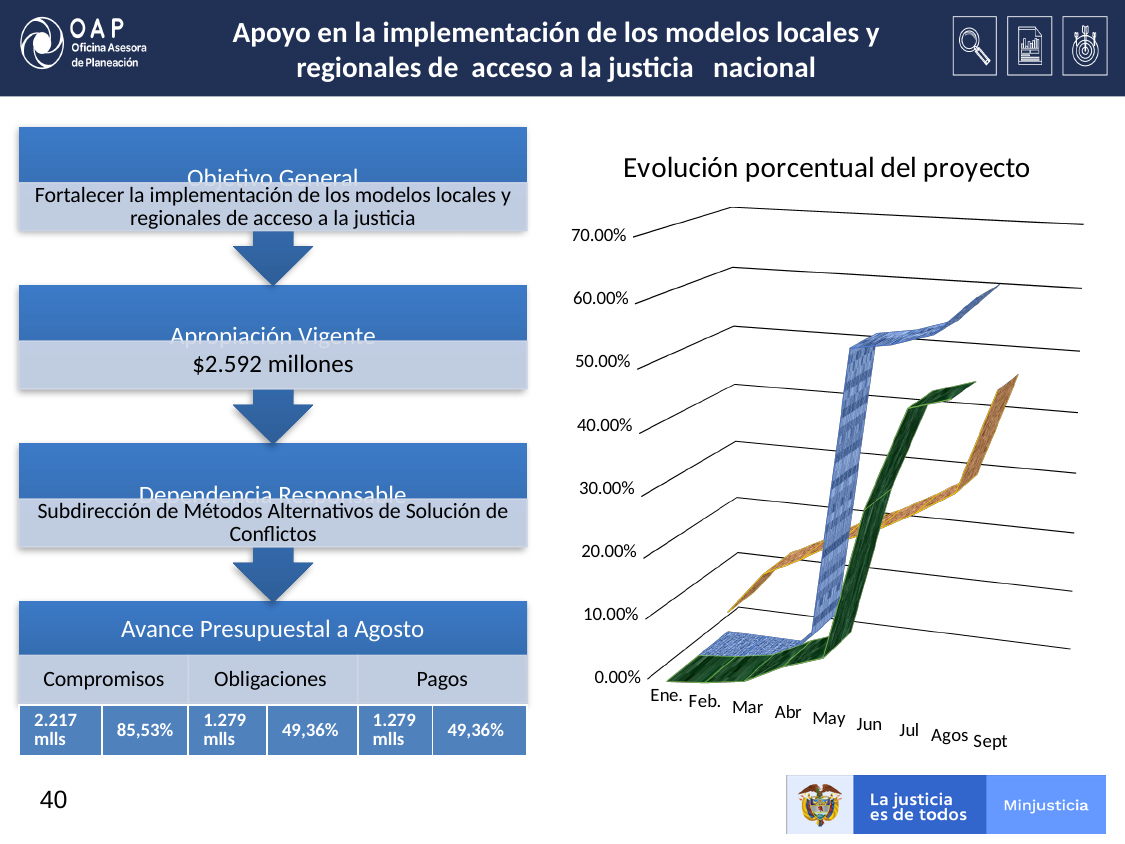
What is the first month label on the x axis of the chart? Ene. How many months are shown on the x axis of the chart? 9 What kind of chart is shown on the slide? line chart How many series are plotted in the chart? 3 What is the title of the chart on the slide? Evolución porcentual del proyecto What is the highest tick value shown on the y axis of the chart? 70.00% Do the values of the series in the chart generally rise or fall from Ene. to Sept? rise Is the final value of the blue series greater or less than 40.00%? greater Which series reaches the highest value in the chart: the blue, green or orange one? blue